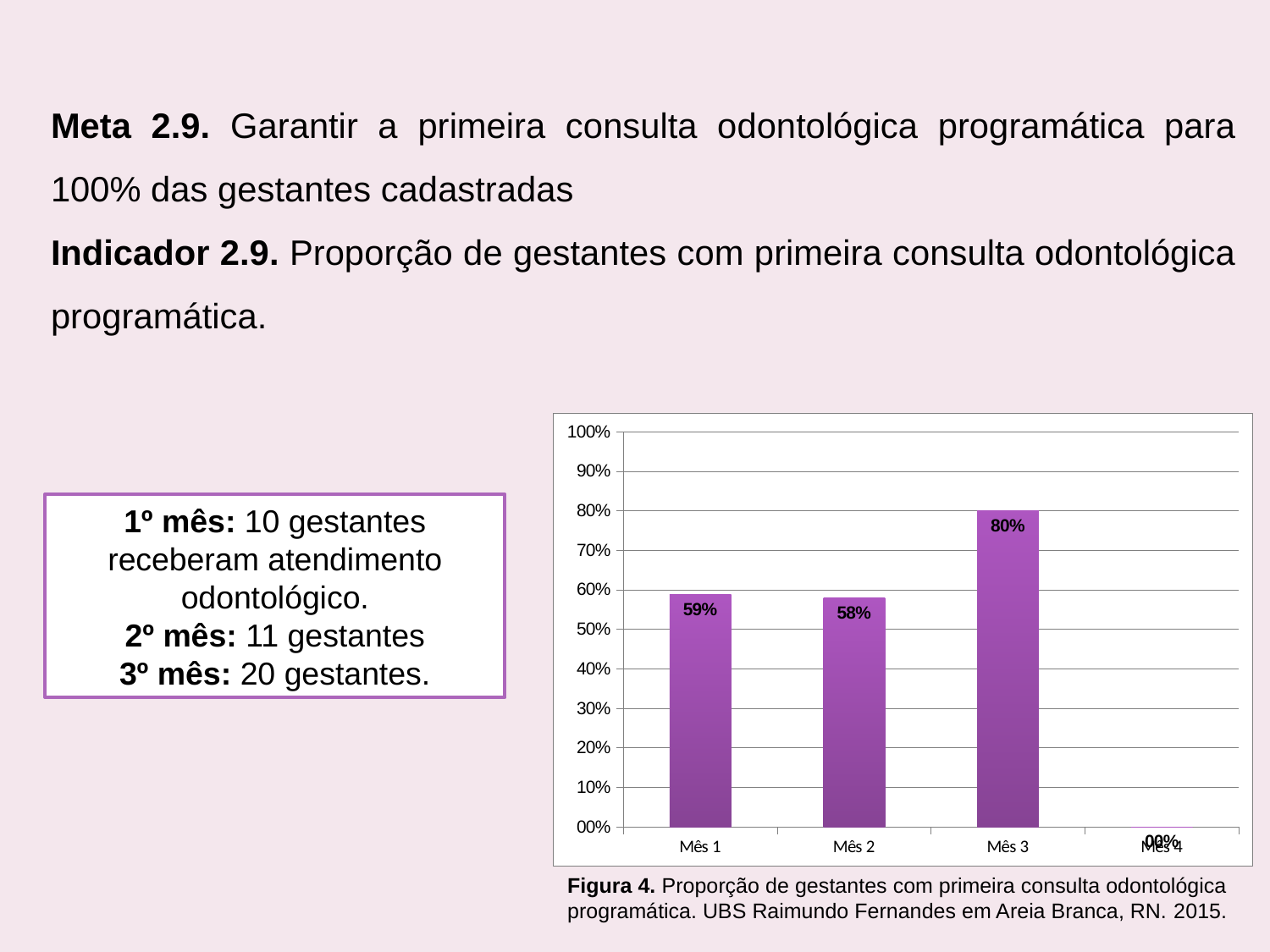
Is the value for Mês 2 greater or less than 60%? less Which is larger, the value for Mês 3 or the value for Mês 1? Mês 3 What is the value for Mês 3? 80% Among Mês 1, Mês 2 and Mês 3, which has the lowest value? Mês 2 How many month categories are shown on the x axis? 4 Which month has the highest proportion? Mês 3 What is the difference between the values for Mês 3 and Mês 2? 22 percentage points Is the value for Mês 3 greater or less than 70%? greater What is the value for Mês 1? 59% What kind of chart is shown on the slide? Bar chart What is the value for Mês 2? 58% What is the difference between the values for Mês 3 and Mês 1? 21 percentage points